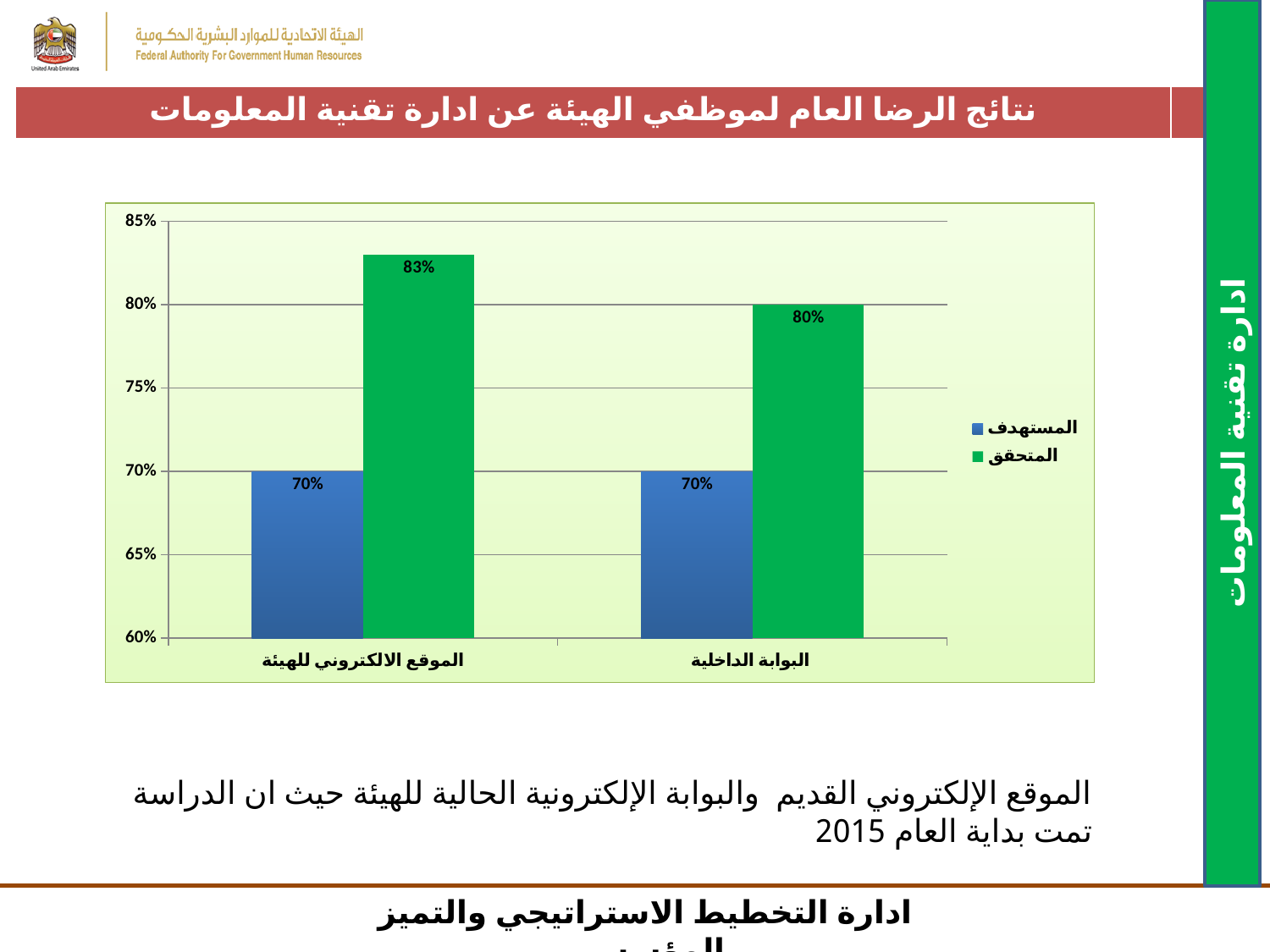
What is the value of المستهدف for البوابة الداخلية? 70% What is the value of المتحقق for الموقع الالكتروني للهيئة? 83% How many series does the legend list? 2 What kind of chart is shown on the slide? Bar chart What is the difference between المتحقق and المستهدف for الموقع الالكتروني للهيئة? 13% What is the difference between المتحقق and المستهدف for البوابة الداخلية? 10% How many categories are shown on the x axis? 2 What is the value of المستهدف for الموقع الالكتروني للهيئة? 70% Which category has the lowest المتحقق value? البوابة الداخلية What is the value of المتحقق for البوابة الداخلية? 80% Which category has the highest المتحقق value? الموقع الالكتروني للهيئة Which is larger for البوابة الداخلية, المستهدف or المتحقق? المتحقق